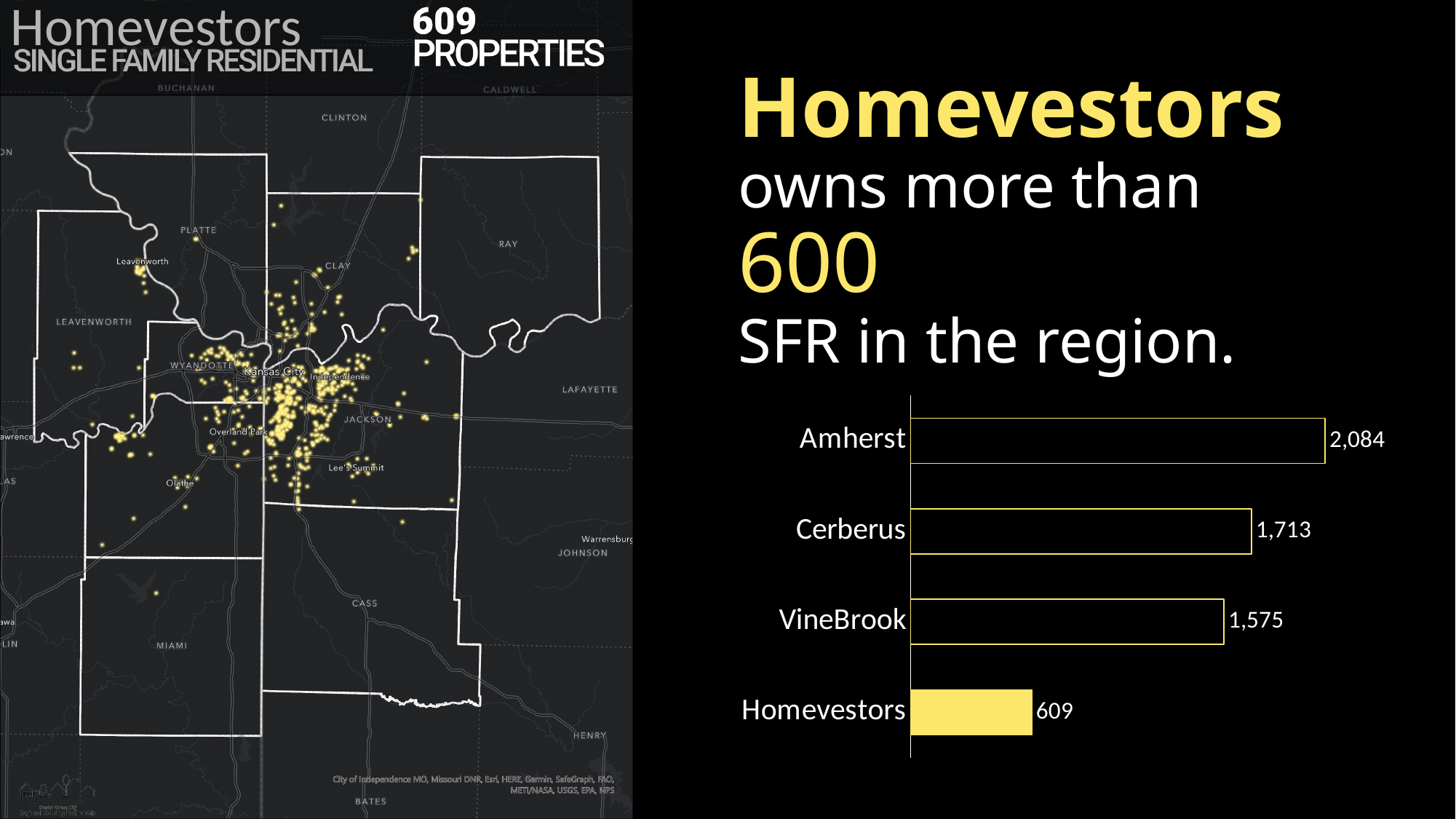
How many categories are shown in the bar chart? 4 What kind of chart is shown on the right side of the slide? Bar chart What is the difference between the values for Amherst and Cerberus? 371 What is the value for VineBrook in the bar chart? 1,575 What is the value for Cerberus in the bar chart? 1,713 What is the value for Homevestors in the bar chart? 609 Which is larger, the value for VineBrook or the value for Homevestors? VineBrook Which category has the lowest value in the bar chart? Homevestors Which category has the highest value in the bar chart? Amherst What is the difference between the values for Cerberus and VineBrook? 138 Which bar in the chart is filled in solid yellow rather than outlined? Homevestors What is the value for Amherst in the bar chart? 2,084